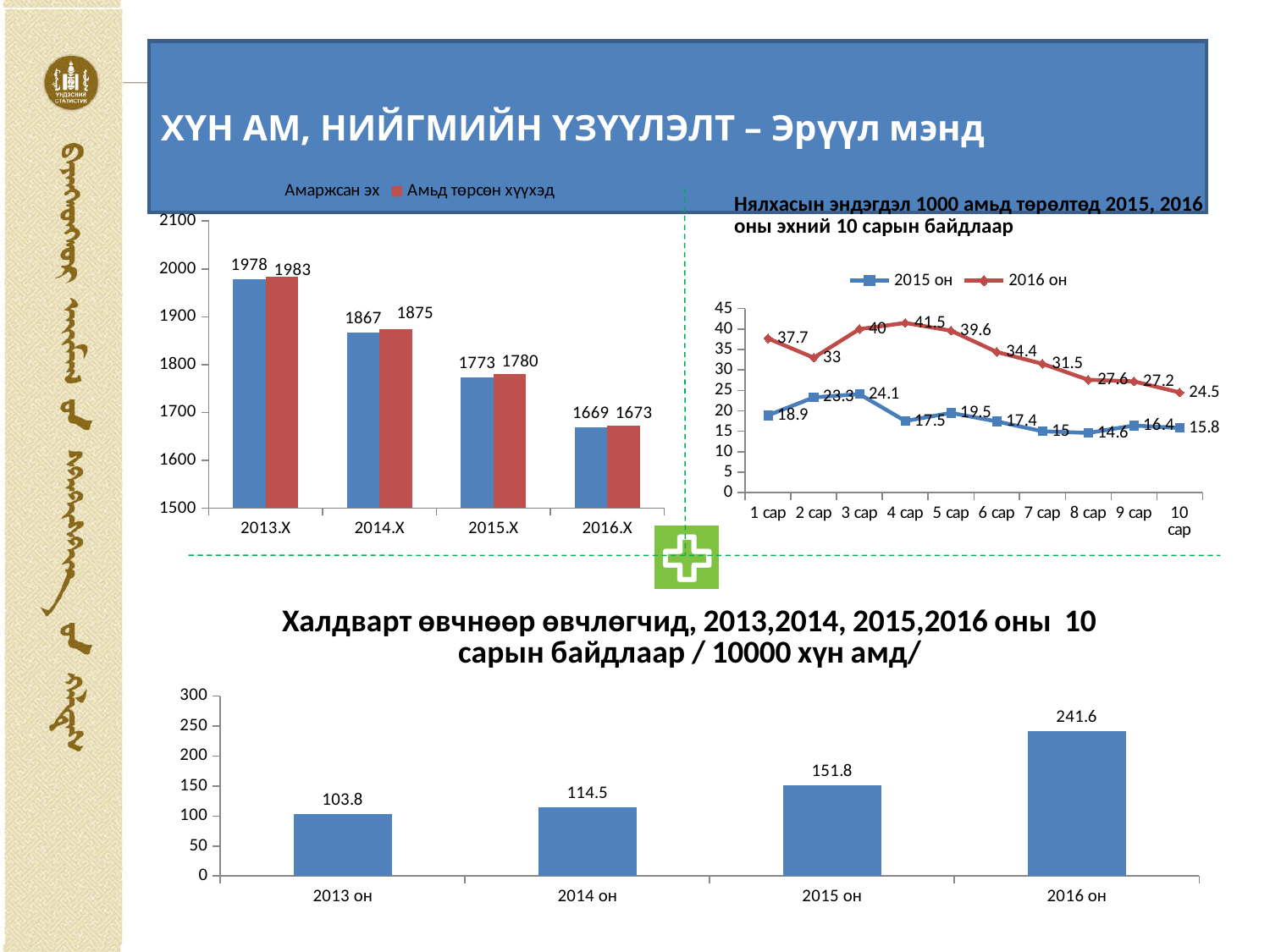
In the top-left bar chart, what is the value for Амьд төрсөн хүүхэд in 2016.X? 1673 How many months are plotted on the x axis of the line chart titled 'Нялхасын эндэгдэл 1000 амьд төрөлтөд 2015, 2016 оны эхний 10 сарын байдлаар'? 10 How many series does the legend of the top-left bar chart list? 2 In the line chart titled 'Нялхасын эндэгдэл 1000 амьд төрөлтөд 2015, 2016 оны эхний 10 сарын байдлаар', which month has the lowest value for 2015 он? 8 сар In the line chart titled 'Нялхасын эндэгдэл 1000 амьд төрөлтөд 2015, 2016 оны эхний 10 сарын байдлаар', what is the value for 2016 он in 4 сар? 41.5 In the top-left bar chart, what is the value for Амаржсан эх in 2013.X? 1978 What kind of chart is the bottom chart titled 'Халдварт өвчнөөр өвчлөгчид, 2013,2014, 2015,2016 оны 10 сарын байдлаар / 10000 хүн амд/'? bar chart In the bottom chart titled 'Халдварт өвчнөөр өвчлөгчид, 2013,2014, 2015,2016 оны 10 сарын байдлаар / 10000 хүн амд/', which year has the highest value? 2016 он In the top-left bar chart, do the values for Амаржсан эх rise or fall from 2013.X to 2016.X? fall In the bottom chart titled 'Халдварт өвчнөөр өвчлөгчид, 2013,2014, 2015,2016 оны 10 сарын байдлаар / 10000 хүн амд/', what is the value for 2015 он? 151.8 In the line chart titled 'Нялхасын эндэгдэл 1000 амьд төрөлтөд 2015, 2016 оны эхний 10 сарын байдлаар', which is larger in 1 сар: 2015 он or 2016 он? 2016 он In the top-left bar chart, what is the difference between Амьд төрсөн хүүхэд and Амаржсан эх in 2014.X? 8